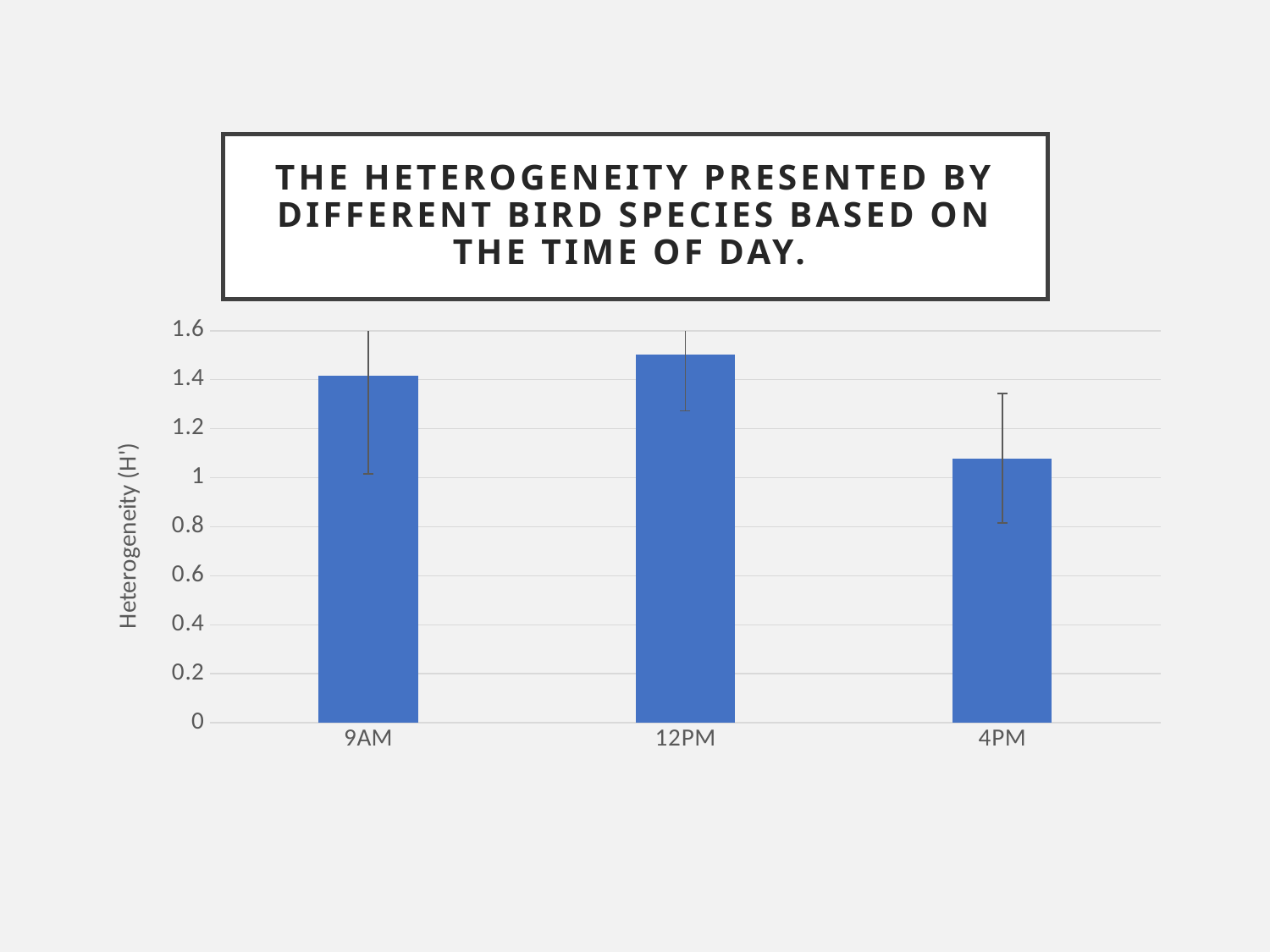
Which time of day has the lowest heterogeneity value? 4PM Is the value for 9AM greater or less than 1.2? greater Is the value for 12PM greater or less than 1.4? greater Is the value for 4PM greater or less than 0.8? greater What kind of chart is shown on the slide? bar chart What is the label on the vertical axis of the chart? Heterogeneity (H') How many time-of-day categories are plotted on the chart? 3 Which has a larger heterogeneity value, 12PM or 4PM? 12PM Which has a larger heterogeneity value, 9AM or 4PM? 9AM Does the heterogeneity value rise or fall from 12PM to 4PM? fall Which time of day has the highest heterogeneity value? 12PM